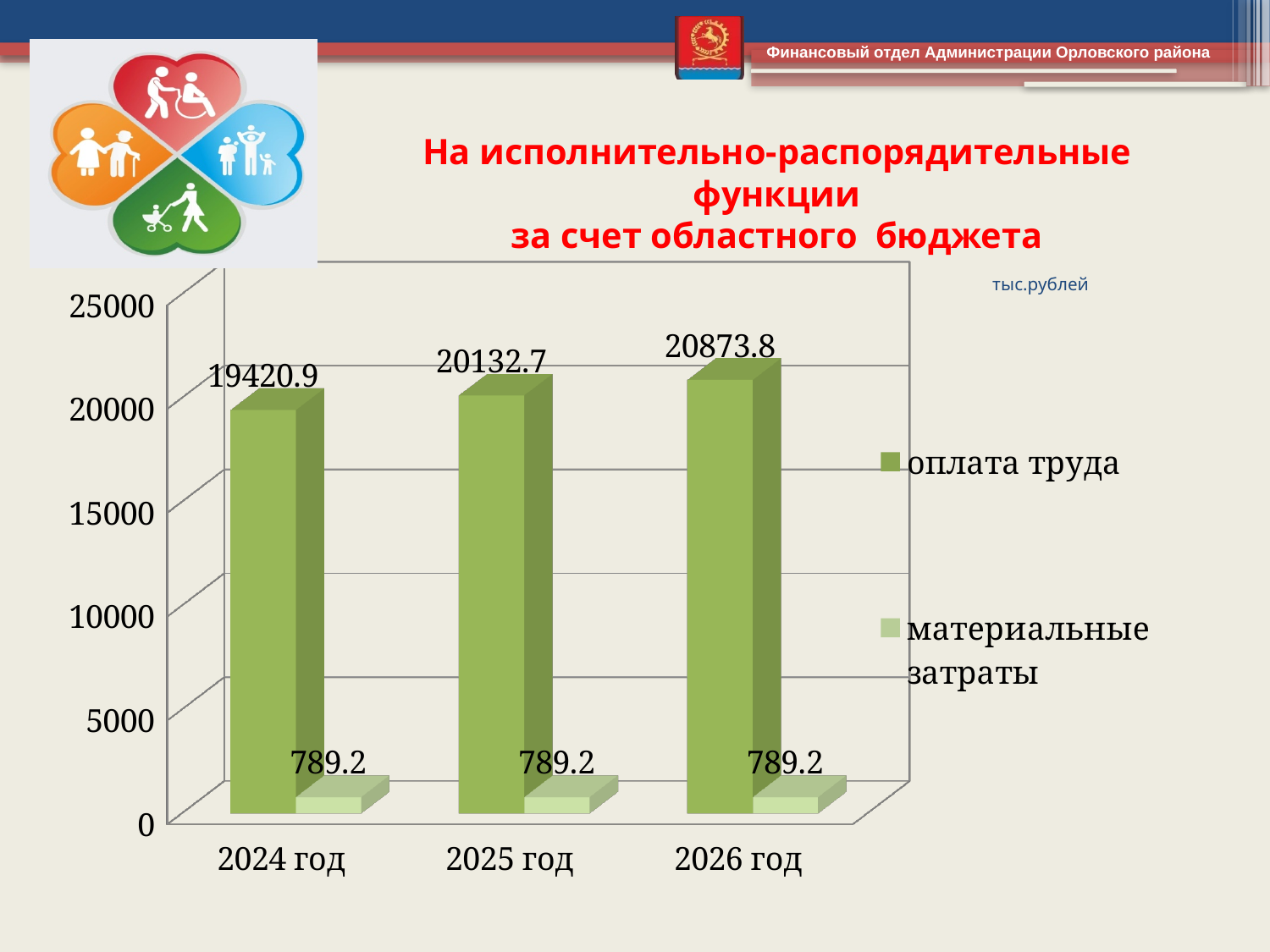
What is the value of оплата труда for 2026 год? 20873.8 Which year has the highest value for оплата труда? 2026 год How many years are shown on the x axis? 3 Is the value of оплата труда for 2025 год greater or less than 20000? greater What kind of chart is shown on the slide? bar chart What is the value of материальные затраты for 2025 год? 789.2 Does the value of оплата труда rise or fall from 2024 год to 2026 год? rise How many series does the legend list? 2 Which is larger: оплата труда in 2025 год or in 2024 год? 2025 год Which year has the lowest value for оплата труда? 2024 год What is the value of оплата труда for 2024 год? 19420.9 What is the difference between оплата труда in 2026 год and 2024 год? 1452.9